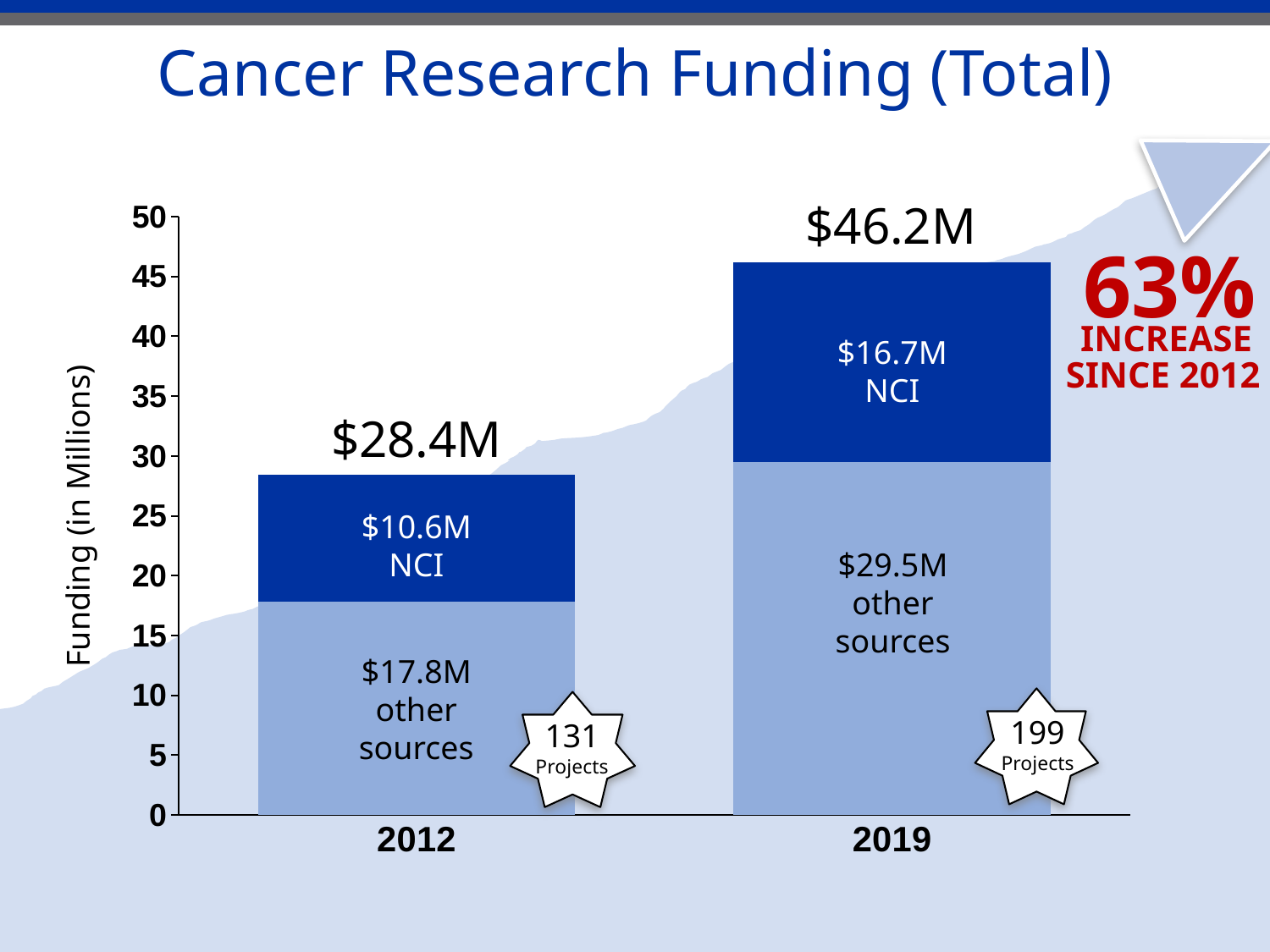
How many years are shown on the x axis? 2 What percentage increase since 2012 does the slide state? 63% How many projects are shown for 2019? 199 What is the funding from other sources in 2012? $17.8M Which year has the lower NCI funding? 2012 Is the NCI funding in 2019 larger or smaller than the funding from other sources in 2019? smaller What is the total cancer research funding shown for 2019? $46.2M What kind of chart is shown on the slide? stacked bar chart What is the funding from other sources in 2019? $29.5M What is the difference in total funding between 2019 and 2012? $17.8M What is the NCI funding amount for 2012? $10.6M Which year has the higher total funding? 2019